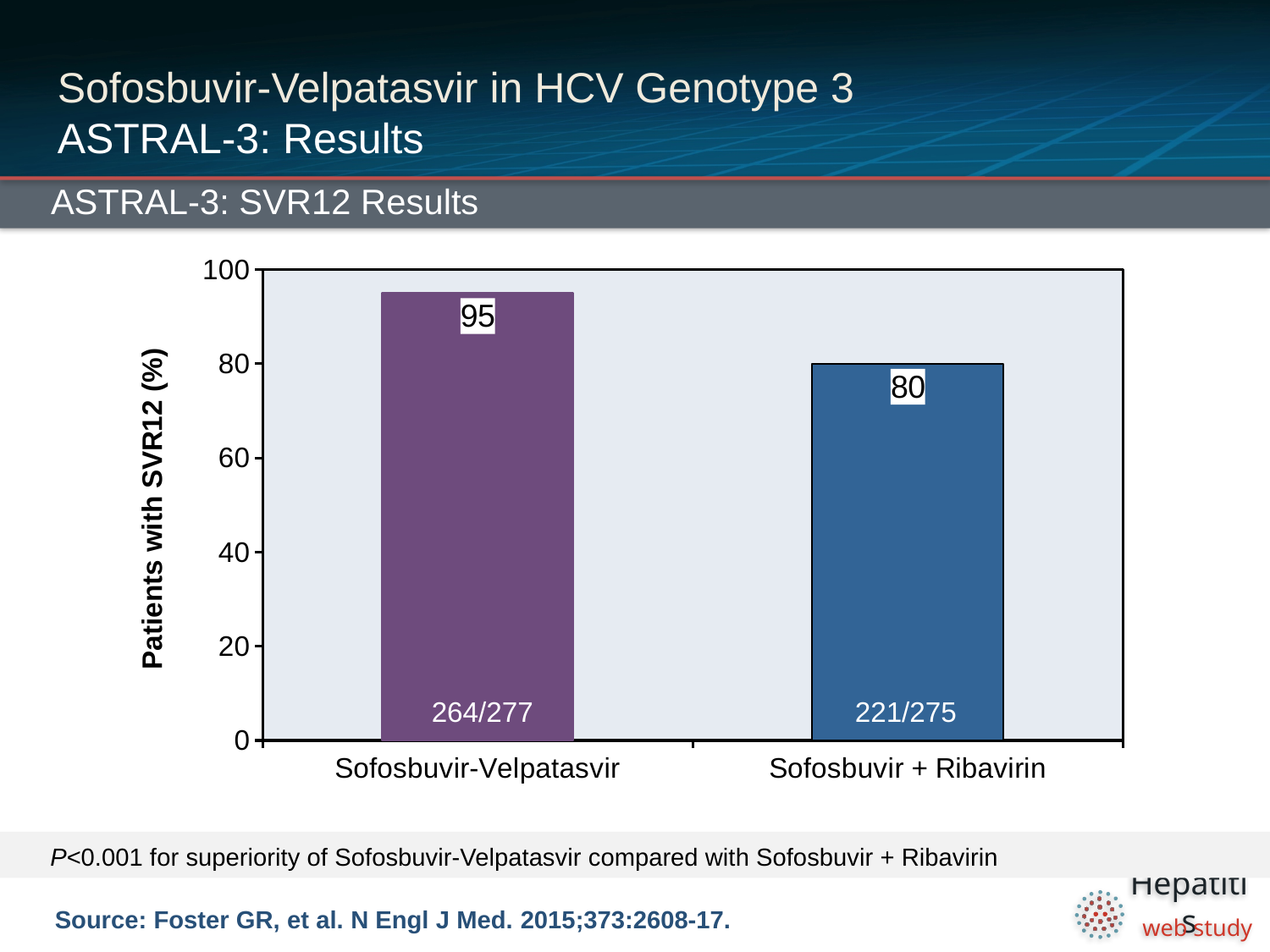
What patient fraction is printed on the Sofosbuvir + Ribavirin bar? 221/275 How many treatment arms are shown on the chart? 2 Which is larger, the SVR12 rate for Sofosbuvir-Velpatasvir or for Sofosbuvir + Ribavirin? Sofosbuvir-Velpatasvir Which treatment arm has the highest SVR12 rate? Sofosbuvir-Velpatasvir What kind of chart is shown on the slide? bar chart Which treatment arm has the lowest SVR12 rate? Sofosbuvir + Ribavirin What is the SVR12 rate for Sofosbuvir + Ribavirin? 80 What is the difference in SVR12 rate between Sofosbuvir-Velpatasvir and Sofosbuvir + Ribavirin? 15 Is the SVR12 rate for Sofosbuvir + Ribavirin greater or less than 60? greater What patient fraction is printed on the Sofosbuvir-Velpatasvir bar? 264/277 What is the SVR12 rate for Sofosbuvir-Velpatasvir? 95 What is the label of the y axis? Patients with SVR12 (%)